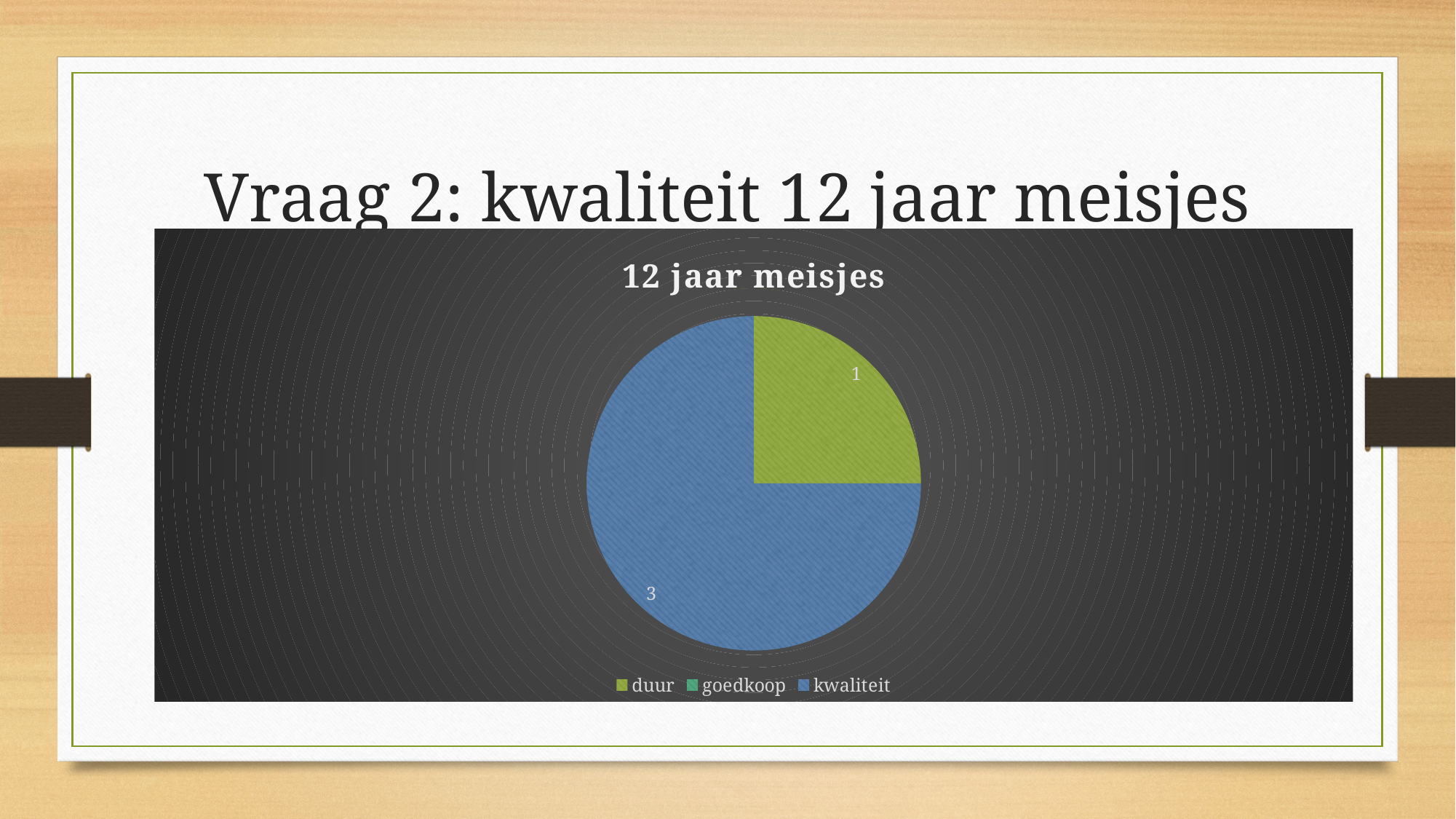
What type of chart is shown on the slide? pie chart What is the value of the 'kwaliteit' slice? 3 How many entries does the legend list? 3 What is the difference between the 'kwaliteit' value and the 'duur' value? 2 How many slices are visible in the pie chart? 2 What is the title of the chart? 12 jaar meisjes Which category has the largest slice in the pie chart? kwaliteit What colour is the 'kwaliteit' slice? blue Which is larger, the value for 'duur' or the value for 'kwaliteit'? kwaliteit What is the value of the 'duur' slice? 1